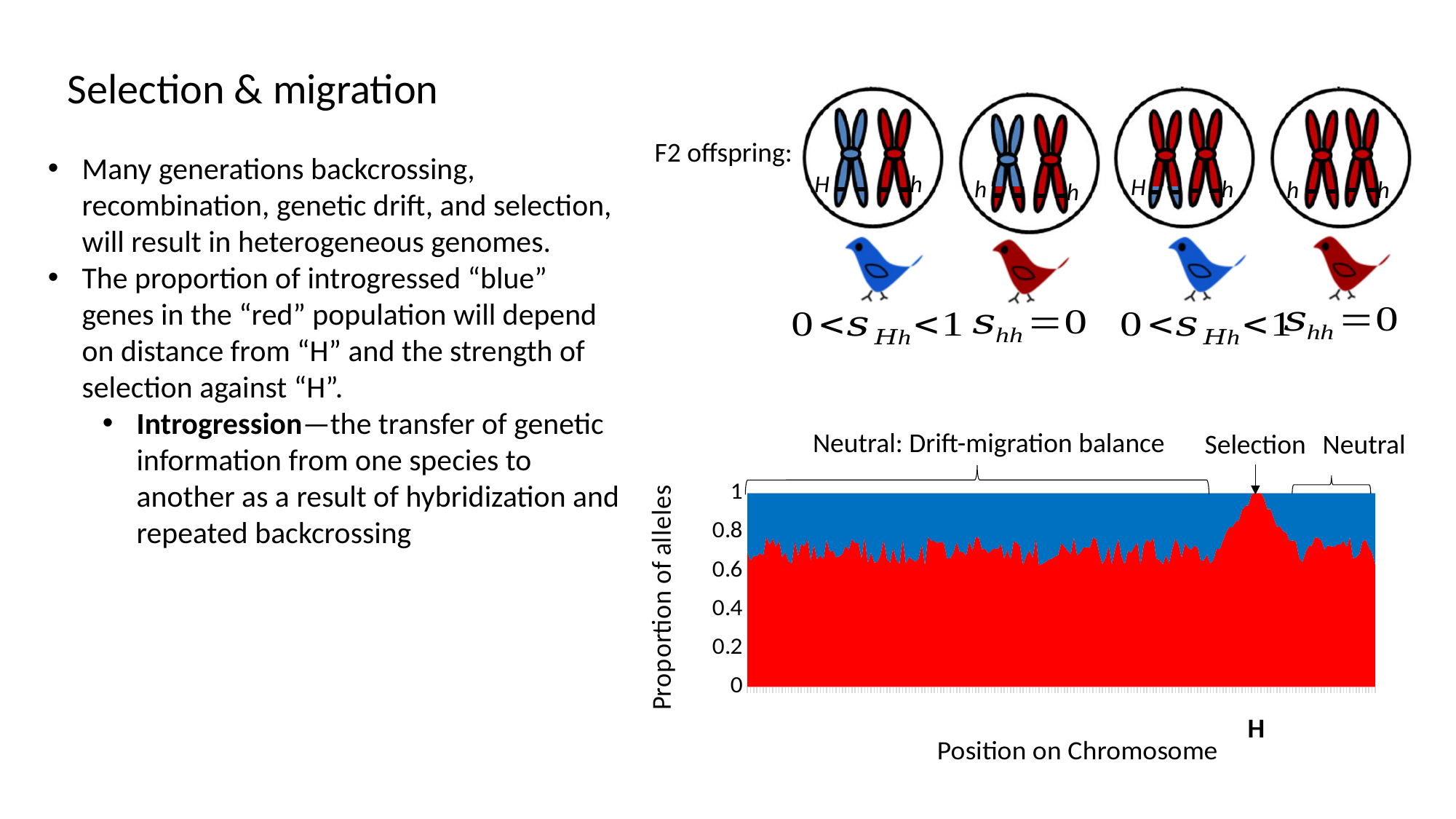
What is the label of the x axis of the chart? Position on Chromosome What is the lowest value shown on the y axis of the chart? 0 In the region labelled 'Neutral: Drift-migration balance', is the proportion of red alleles greater or less than 0.9? less Is the proportion of blue alleles at the position marked H greater or less than 0.2? less Is the proportion of red alleles larger at the position marked H or in the region labelled 'Neutral: Drift-migration balance'? at H What is the highest value shown on the y axis of the chart? 1 What kind of chart is shown at the bottom right of the slide? area chart At which labelled position on the chromosome does the proportion of red alleles reach its highest value? H In the region labelled 'Neutral: Drift-migration balance', is the proportion of red alleles greater or less than 0.4? greater Which region of the chart is labelled 'Selection'? the peak at position H What is the label of the y axis of the chart? Proportion of alleles